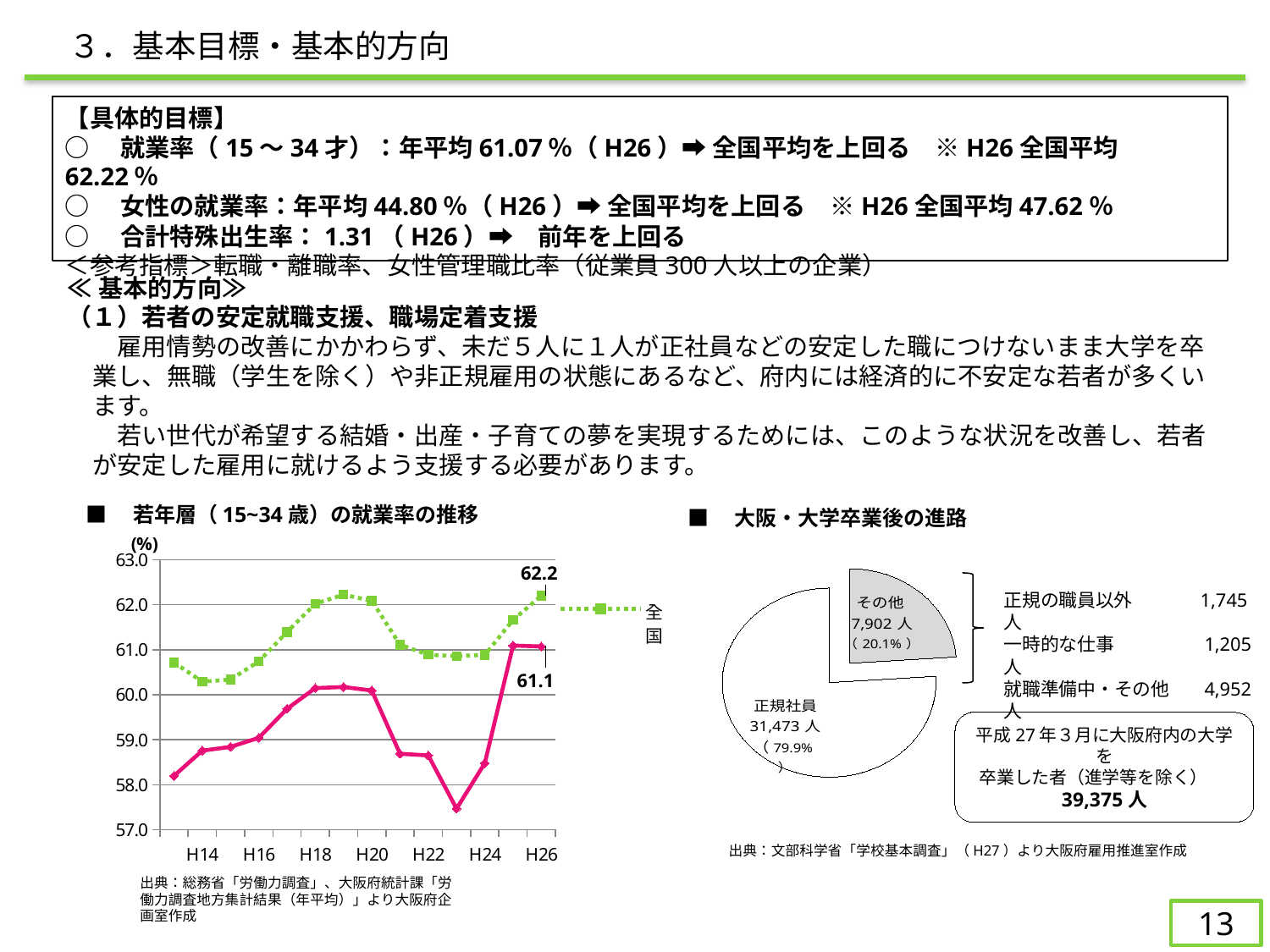
In the 若年層（15~34歳）の就業率の推移 chart, in which year does the pink line reach its lowest point? H23 In the 若年層（15~34歳）の就業率の推移 chart, what is the 全国 value at H26? 62.2 In the 大阪・大学卒業後の進路 chart, how many people are 正規社員? 31,473人 In the 若年層（15~34歳）の就業率の推移 chart, is the 全国 value at H14 greater or less than 60.0? greater In the 若年層（15~34歳）の就業率の推移 chart, what is the difference between the 全国 value and the pink line value at H26? 1.1 What kind of chart is the 大阪・大学卒業後の進路 chart? pie chart In the 若年層（15~34歳）の就業率の推移 chart, at H26 which is higher, the 全国 line or the pink line? 全国 In the 大阪・大学卒業後の進路 chart, what share of the pie is その他? 20.1% In the 大阪・大学卒業後の進路 chart, how many slices does the pie have? 2 What kind of chart is the 若年層（15~34歳）の就業率の推移 chart? line chart In the 若年層（15~34歳）の就業率の推移 chart, what is the value of the solid pink line at H26? 61.1 In the 若年層（15~34歳）の就業率の推移 chart, is the pink line's value at H23 greater or less than 58.0? less